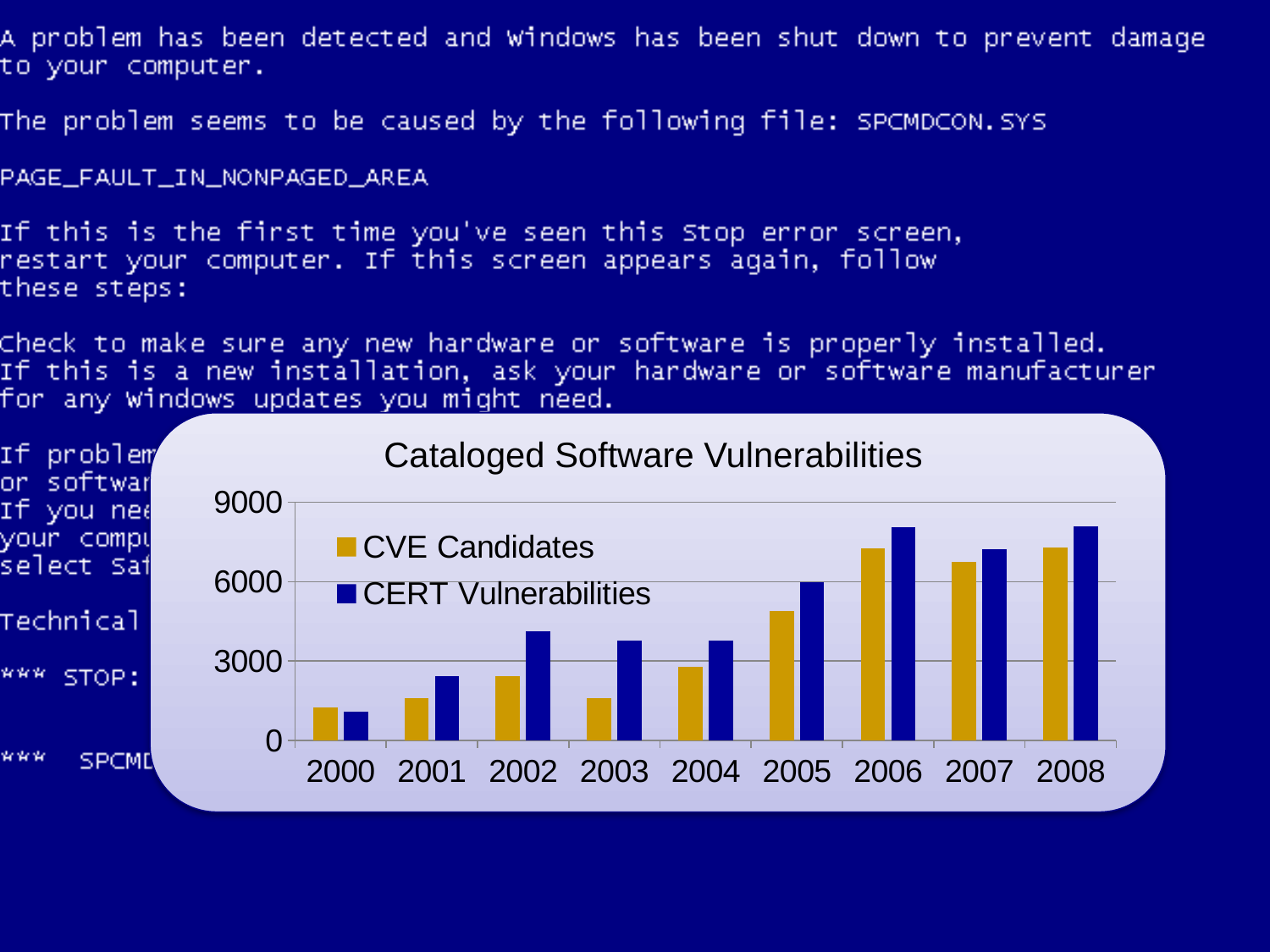
Do the CERT Vulnerabilities values rise or fall from 2000 to 2002? rise Which series is drawn in blue? CERT Vulnerabilities What kind of chart is shown on the slide? bar chart Is the value for CERT Vulnerabilities in 2006 greater or less than 6000? greater Is the value for CVE Candidates in 2005 greater or less than 6000? less In which year is the CERT Vulnerabilities value lowest? 2000 Is the value for CVE Candidates in 2002 greater or less than 3000? less What is the title of the chart? Cataloged Software Vulnerabilities How many series does the chart's legend list? 2 In 2001, which is larger: CVE Candidates or CERT Vulnerabilities? CERT Vulnerabilities How many years are shown on the x axis of the chart? 9